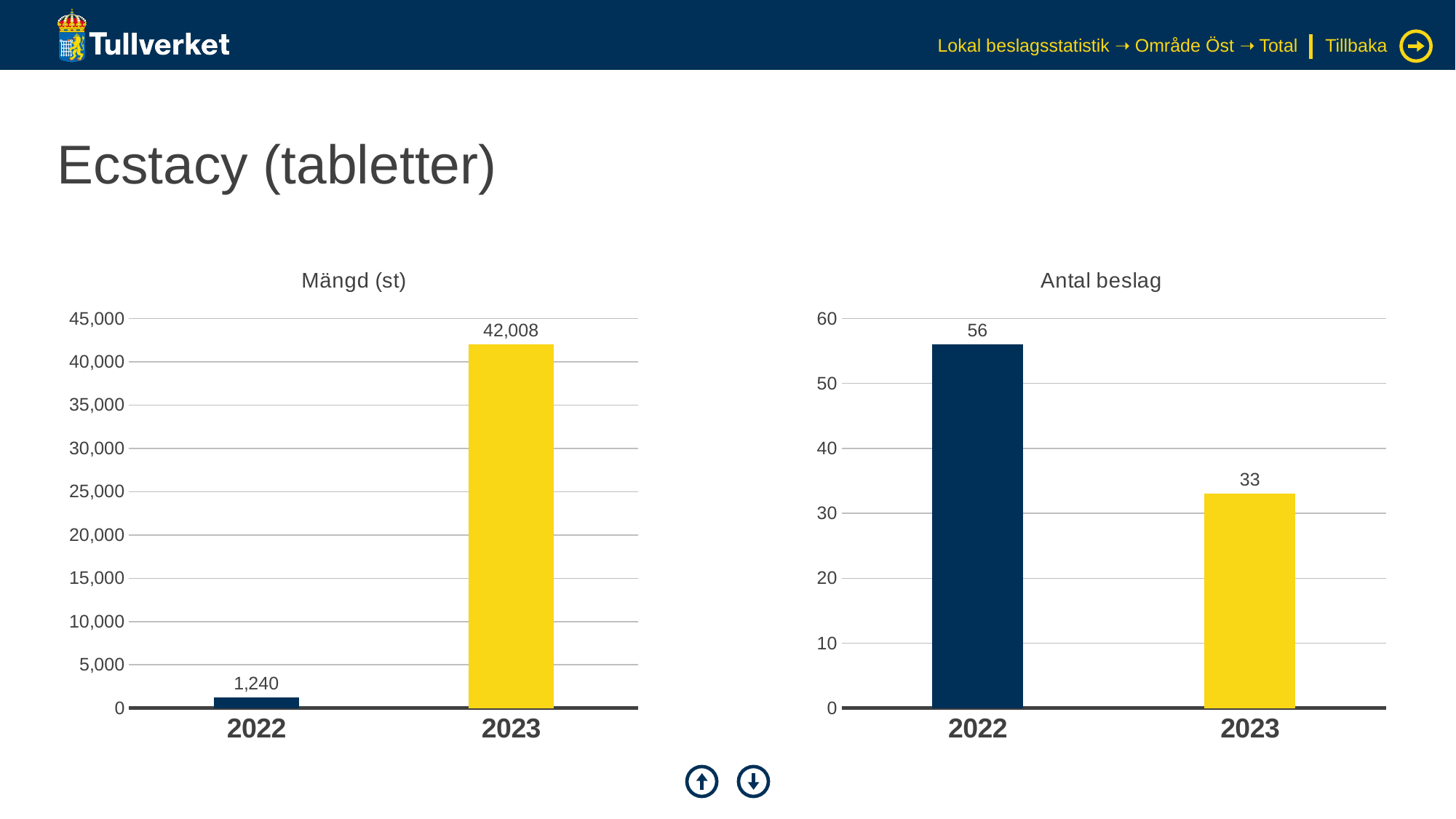
In the 'Antal beslag' chart, which year has the lowest value? 2023 In the 'Mängd (st)' chart, what is the value for 2022? 1,240 In the 'Antal beslag' chart, what is the value for 2023? 33 In the 'Mängd (st)' chart, which year has the highest value? 2023 In the 'Antal beslag' chart, what is the value for 2022? 56 In the 'Mängd (st)' chart, do the values rise or fall from 2022 to 2023? rise How many categories does the 'Antal beslag' chart show? 2 In the 'Antal beslag' chart, what is the difference between the values for 2022 and 2023? 23 In the 'Antal beslag' chart, is the value for 2022 greater or less than 50? greater In the 'Mängd (st)' chart, what is the difference between the values for 2023 and 2022? 40,768 What kind of chart is the 'Mängd (st)' chart? bar chart In the 'Mängd (st)' chart, what is the value for 2023? 42,008